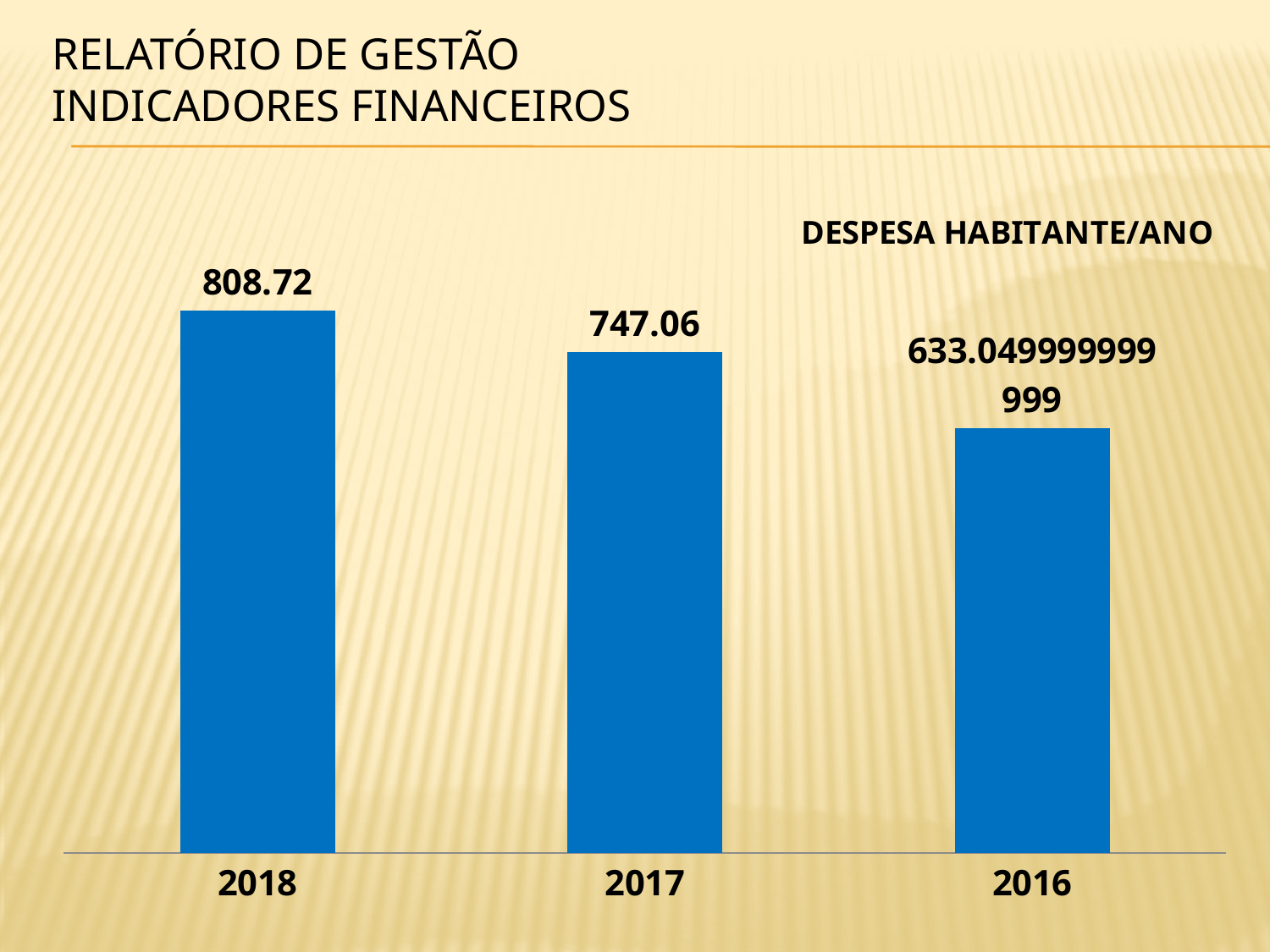
Which year has the lowest value? 2016 Do the values rise or fall from left to right along the x axis? Fall What value is printed above the bar for 2016? 633.049999999999999 What colour are the bars in the chart? Blue How many bars are shown in the chart? 3 What is the title of the chart? DESPESA HABITANTE/ANO What is the difference between the values for 2018 and 2017? 61.66 Which year has the highest value? 2018 What is the value for 2018? 808.72 Which is larger, the value for 2017 or the value for 2016? 2017 What is the value for 2017? 747.06 What kind of chart is shown on the slide? Bar chart